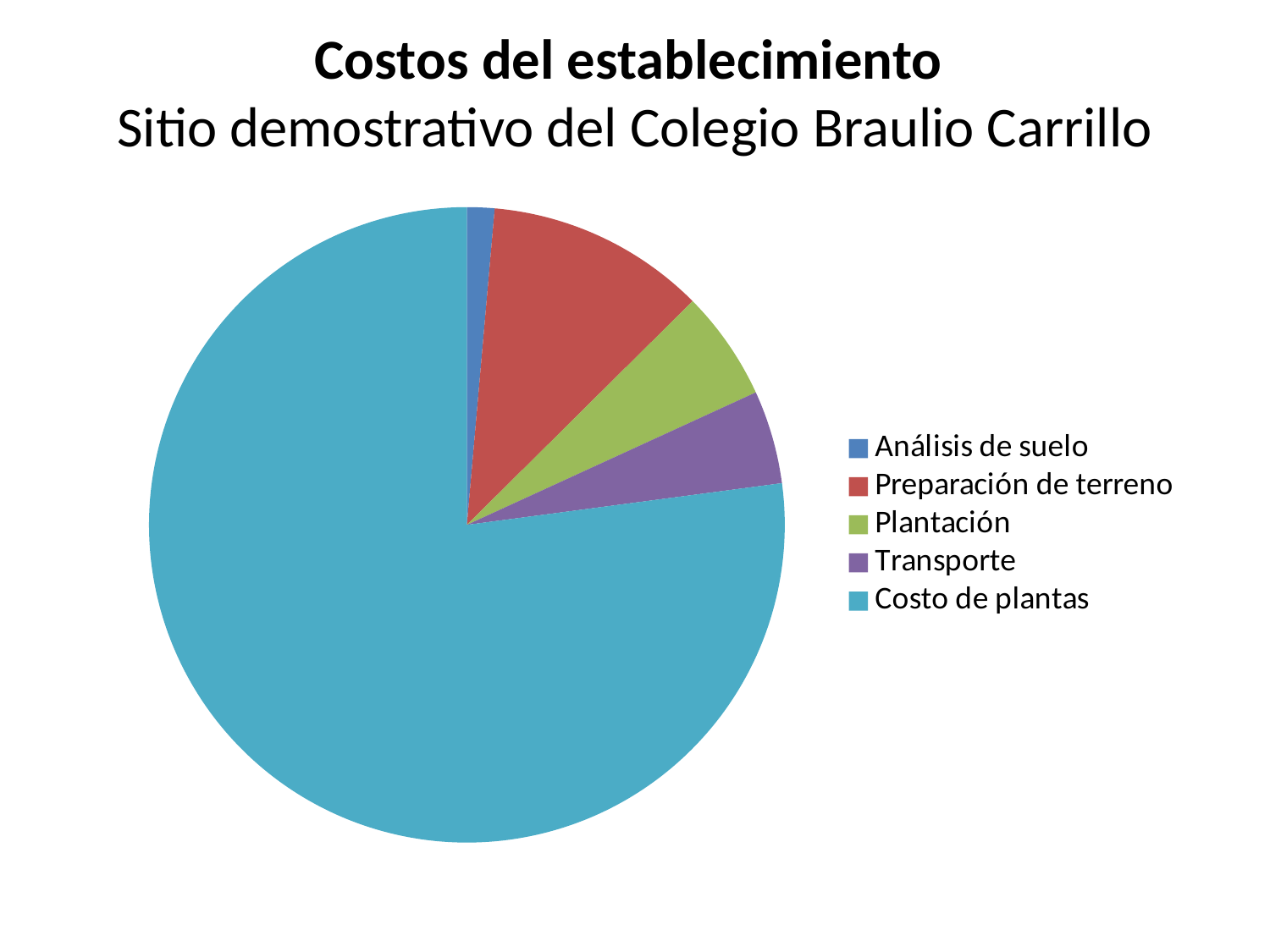
How many slices does the pie chart have? 5 Which category is shown in red in the pie chart? Preparación de terreno Which slice is larger, Análisis de suelo or Transporte? Transporte Which category has the largest slice of the pie? Costo de plantas What is the bold title of the chart on the slide? Costos del establecimiento Does Costo de plantas account for more or less than half of the pie? more What kind of chart is shown on the slide? pie chart How many entries does the legend list? 5 Which slice is larger, Preparación de terreno or Plantación? Preparación de terreno Which category has the smallest slice of the pie? Análisis de suelo Which slice is larger, Costo de plantas or Preparación de terreno? Costo de plantas